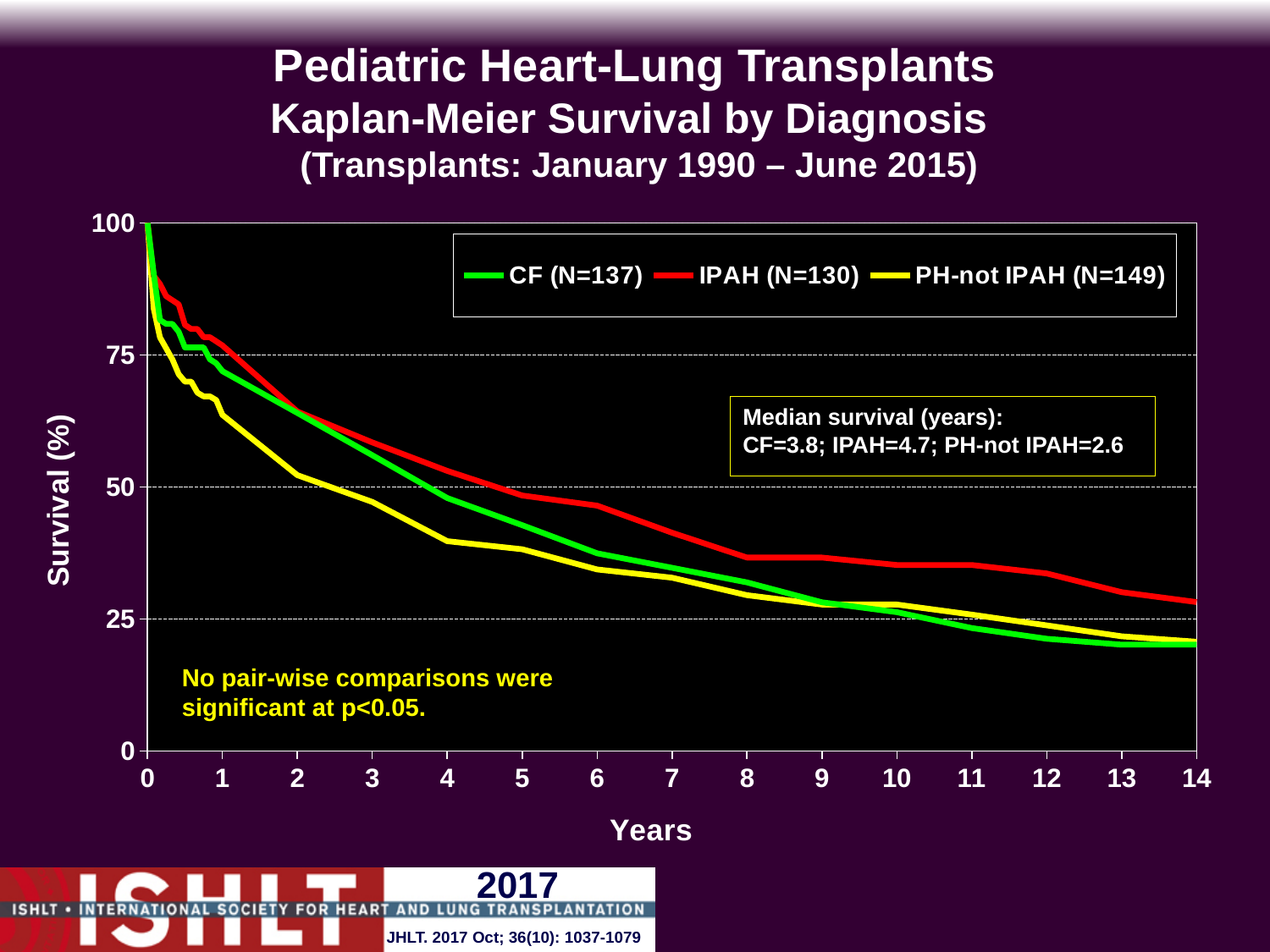
What is the difference in median survival (years) between IPAH and PH-not IPAH? 2.1 Is the survival for PH-not IPAH at 4 years greater or less than 50%? less Which diagnosis group has the highest median survival? IPAH Do the survival curves rise or fall as years increase? fall What is the median survival in years for the PH-not IPAH group? 2.6 How many series does the legend list? 3 Which diagnosis group has the lowest median survival? PH-not IPAH What is the median survival in years for the IPAH group? 4.7 What kind of chart is shown on the slide? line chart How many patients (N) are in the CF group according to the legend? 137 What is the median survival in years for the CF group? 3.8 Is the survival for IPAH at 14 years greater or less than 25%? greater